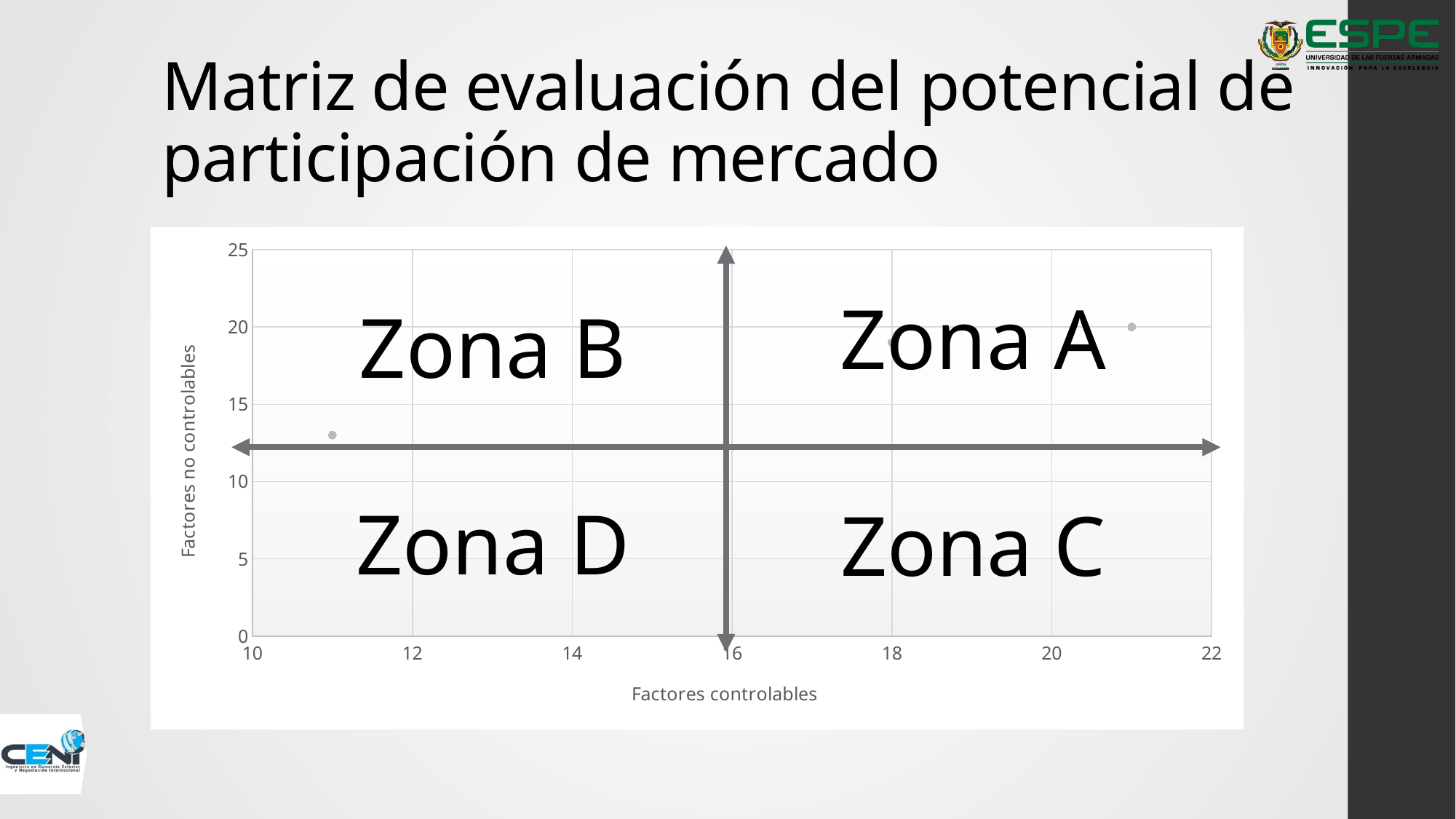
What is the minimum value shown on the horizontal axis of the chart? 10 What is the title of the vertical axis of the chart? Factores no controlables Is the vertical-axis value of the point plotted in Zona B greater or less than 15? less Which zone label appears in the lower-right quadrant of the chart? Zona C What kind of chart is shown on the slide? scatter chart Is the horizontal-axis value of the point plotted in Zona A near the right edge greater or less than 20? greater Is the horizontal-axis value of the point plotted in Zona B greater or less than 12? less Which plotted point has the higher vertical-axis value: the one in Zona B or the one in Zona A near the right edge? the one in Zona A What is the title of the horizontal axis of the chart? Factores controlables What is the maximum value shown on the vertical axis of the chart? 25